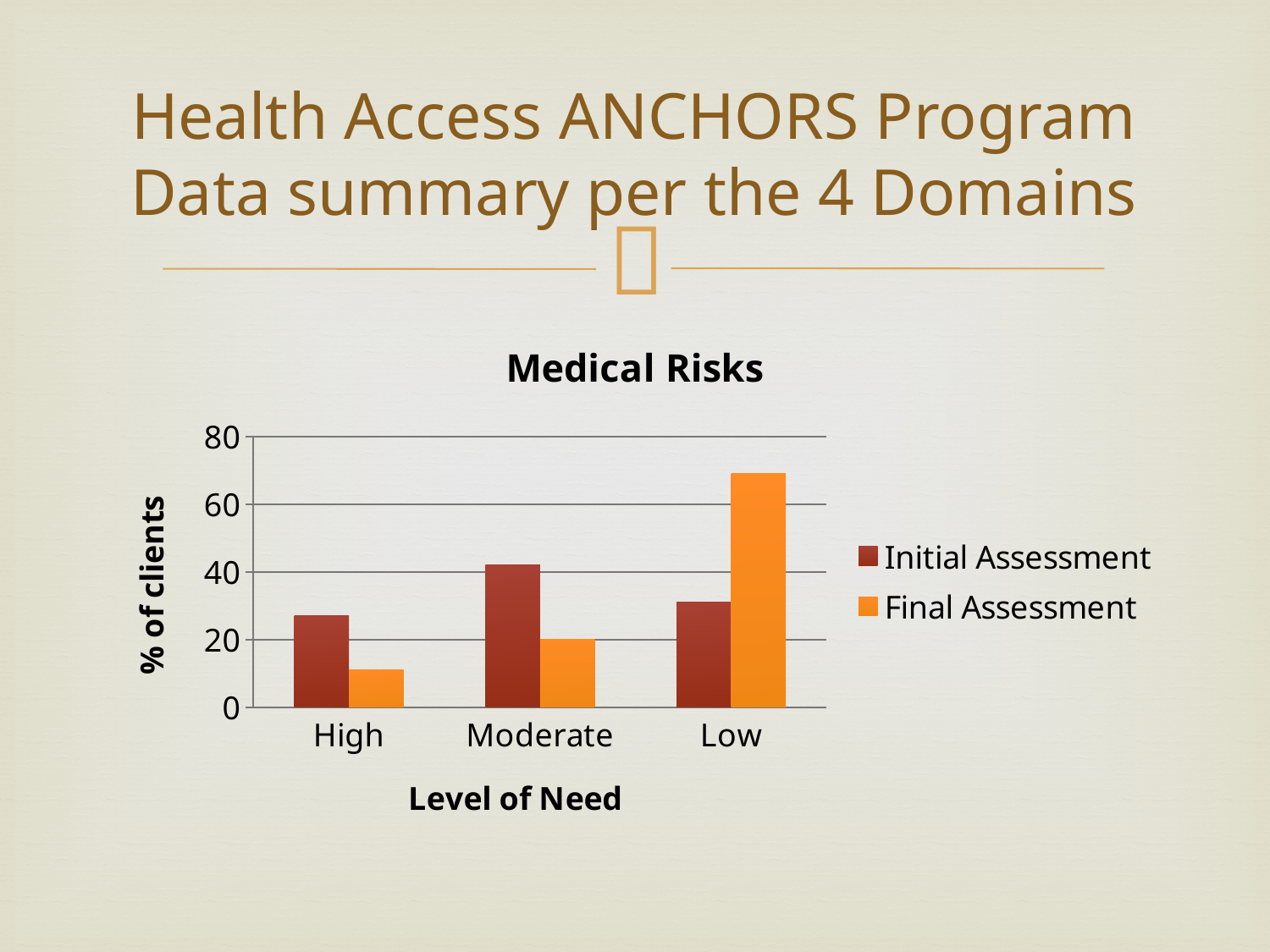
Is the Initial Assessment value for Low greater or less than 40? less Which level of need has the highest Final Assessment value? Low Is the Final Assessment value for Low greater or less than 60? greater For the Low level of need, which is larger: Initial Assessment or Final Assessment? Final Assessment How many series does the legend list? 2 What type of chart is shown on the slide? bar chart How many levels of need are shown on the x axis? 3 Which level of need has the lowest Final Assessment value? High What is the title of the chart? Medical Risks For the High level of need, which is larger: Initial Assessment or Final Assessment? Initial Assessment Which level of need has the highest Initial Assessment value? Moderate Is the Final Assessment value for High greater or less than 20? less